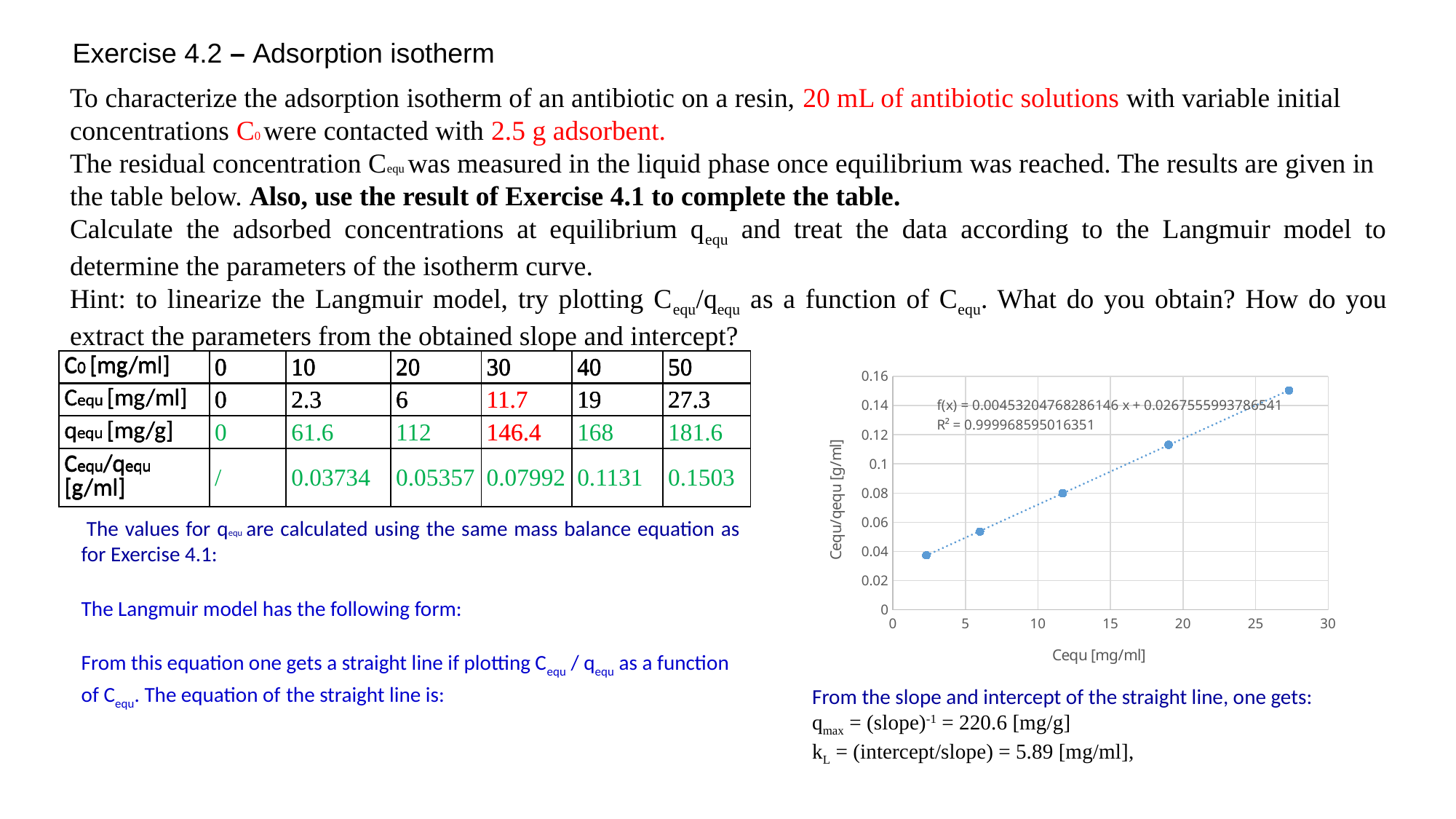
Is the Cequ/qequ value of the leftmost data point greater or less than 0.06? less What is the R² value shown for the trendline in the chart? 0.999968595016351 Is the Cequ/qequ value of the data point near Cequ = 12 greater or less than 0.1? less What is the title of the y axis of the chart? Cequ/qequ [g/ml] Is the Cequ/qequ value of the data point near Cequ = 19 greater or less than 0.1? greater What is the slope of the trendline equation displayed on the chart? 0.00453204768286146 How many data points are plotted in the chart? 5 Do the plotted values of Cequ/qequ rise or fall as Cequ increases? rise What is the intercept of the trendline equation displayed on the chart? 0.0267555993786541 What is the title of the x axis of the chart? Cequ [mg/ml] What kind of chart is shown on the slide? scatter chart